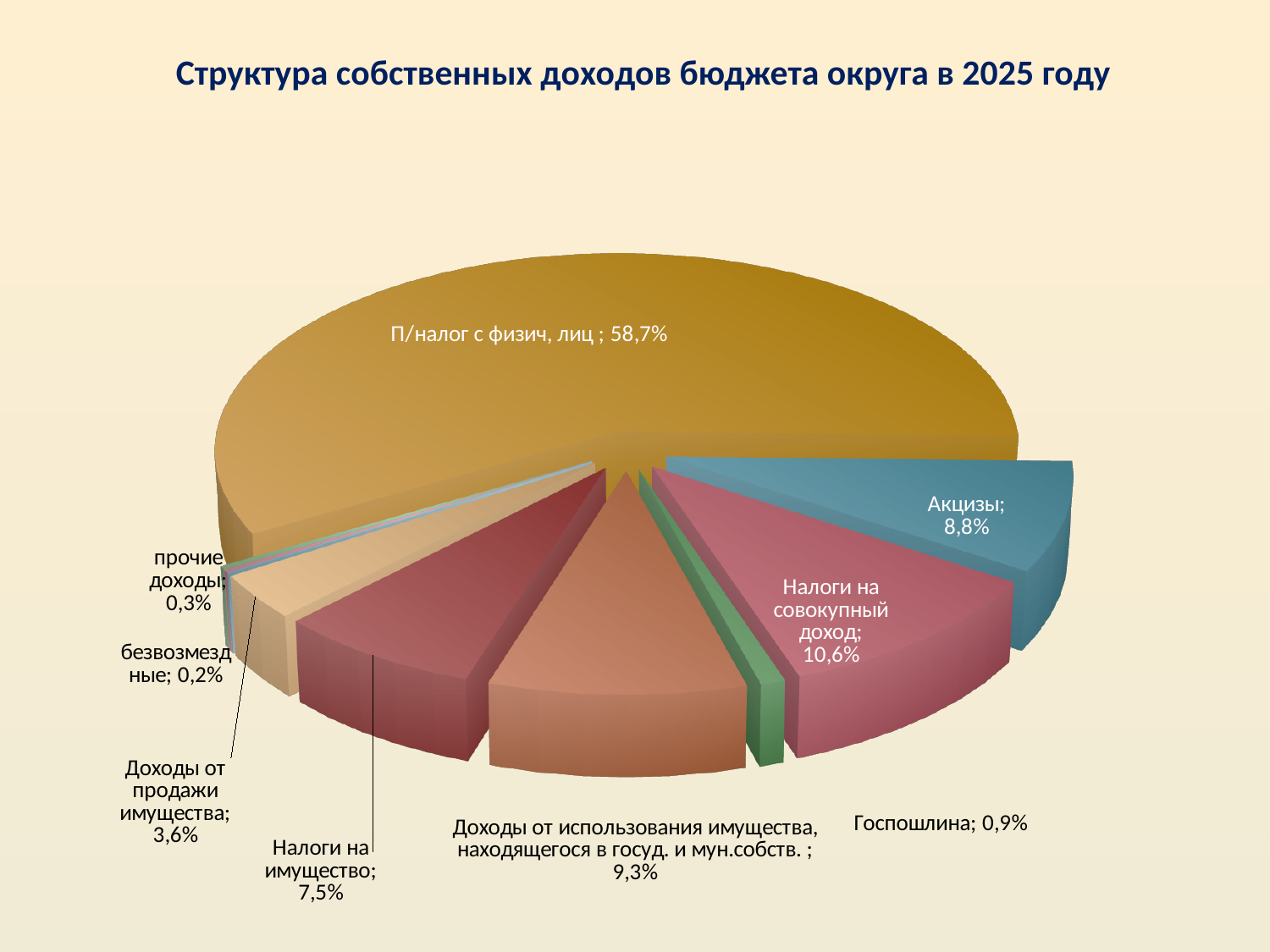
What is the share of "Акцизы"? 8,8% What is the share of "П/налог с физич, лиц" in the pie chart? 58,7% How many slices does the pie chart have? 10 Which is larger: "Налоги на совокупный доход" or "Акцизы"? Налоги на совокупный доход What is the share of "Налоги на имущество"? 7,5% What is the share of "Госпошлина"? 0,9% What is the share of "Налоги на совокупный доход"? 10,6% What is the share of "Доходы от продажи имущества"? 3,6% What kind of chart is shown on the slide? Pie chart What is the difference between the shares of "Доходы от использования имущества, находящегося в госуд. и мун.собств." and "Налоги на имущество"? 1,8% Which category has the largest share of the pie? П/налог с физич, лиц